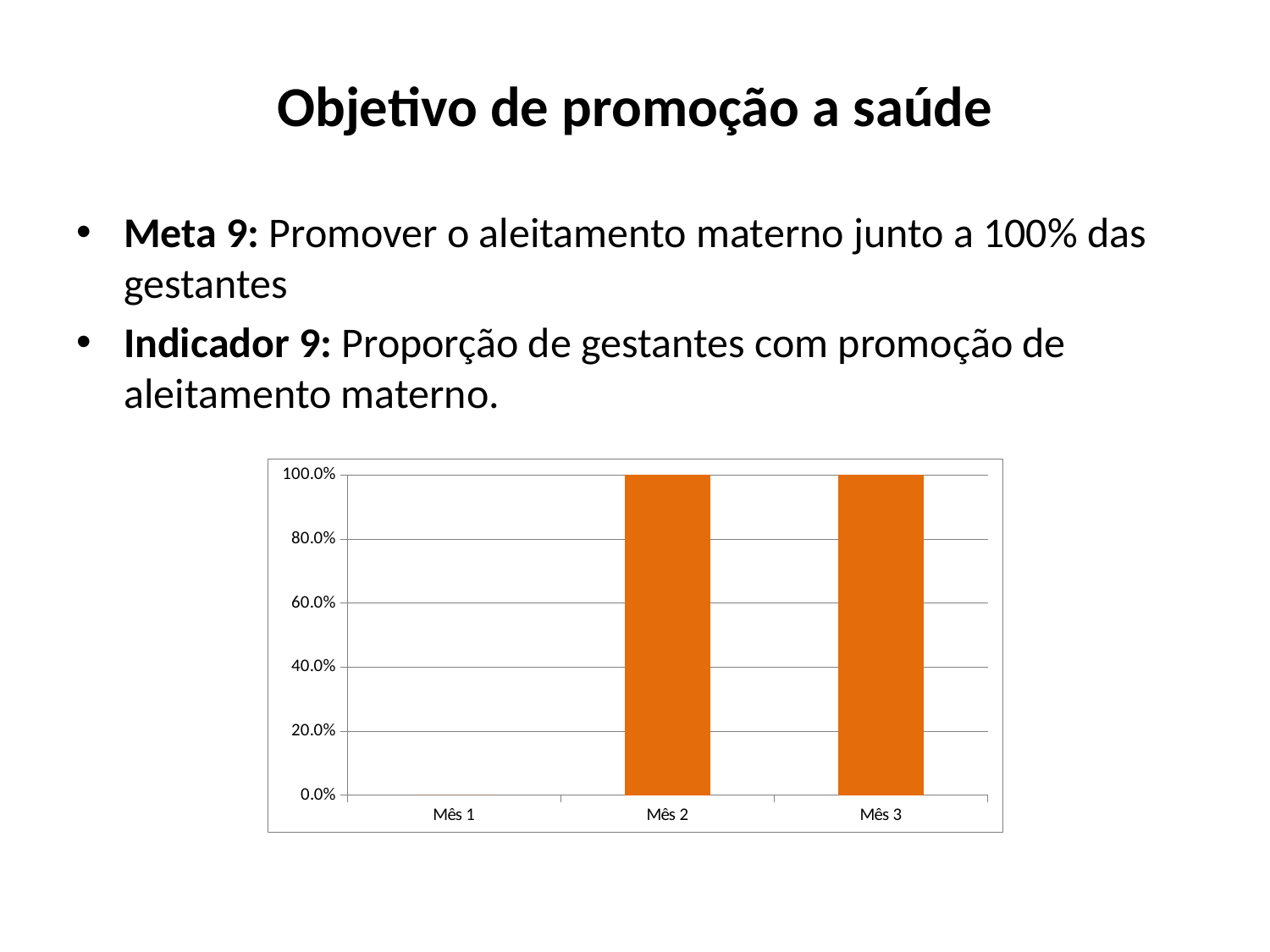
How many categories are shown on the x axis? 3 Do the values rise or fall from Mês 1 to Mês 2? rise Is the value for Mês 1 greater or less than 20.0%? less What is the value for Mês 2? 100.0% Which is larger, the value for Mês 1 or the value for Mês 2? Mês 2 Is the value for Mês 2 greater or less than 80.0%? greater What kind of chart is shown on the slide? bar chart What colour are the bars in the chart? orange What is the value for Mês 3? 100.0% What is the difference between the values for Mês 2 and Mês 1? 100.0% What is the value for Mês 1? 0.0% Which category has the lowest value? Mês 1